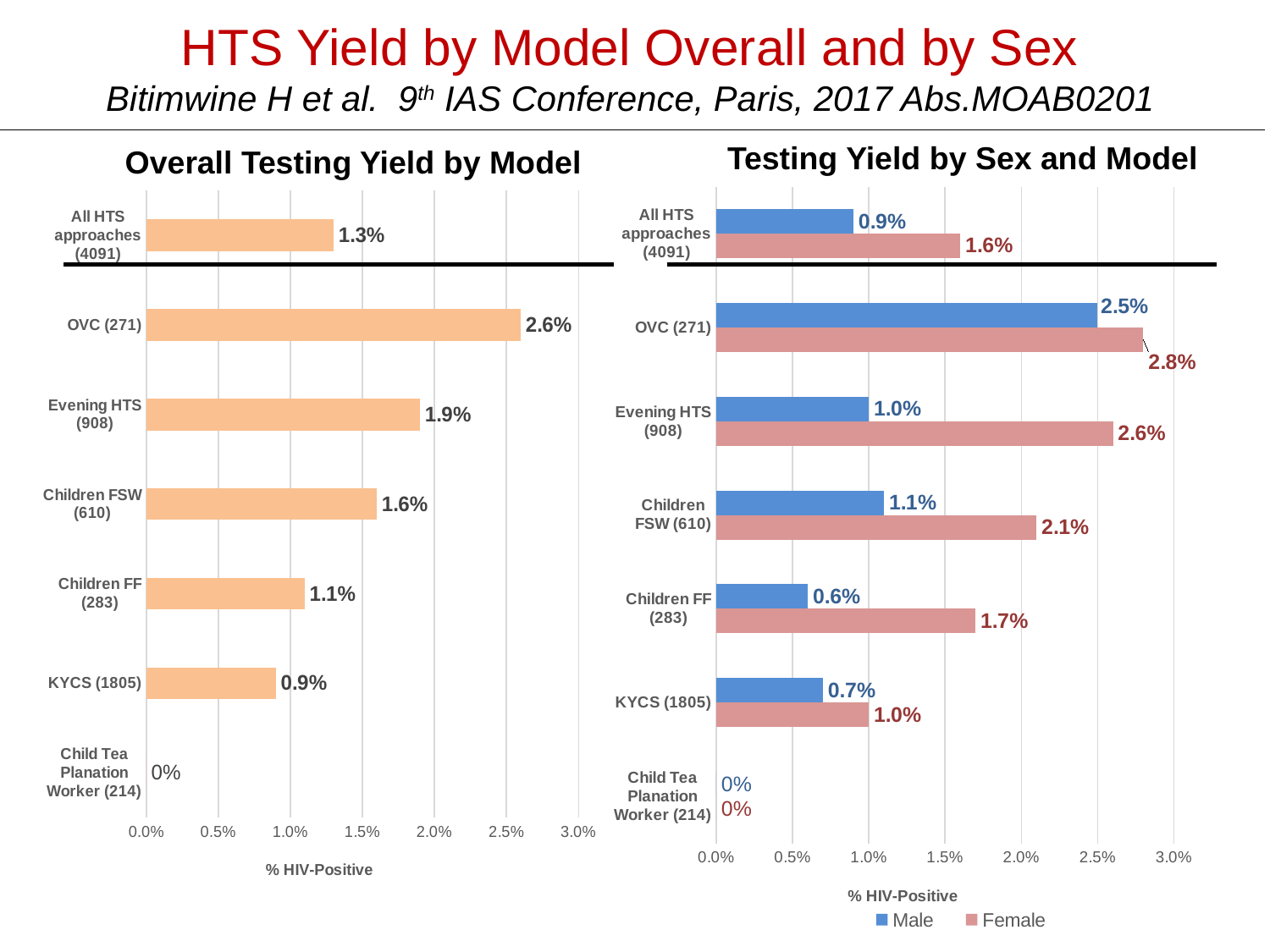
What type of chart is the 'Overall Testing Yield by Model' chart? Bar chart In the 'Testing Yield by Sex and Model' chart, what is the difference between the Female and Male values for All HTS approaches (4091)? 0.7% How many series does the legend of the 'Testing Yield by Sex and Model' chart list? 2 In the 'Overall Testing Yield by Model' chart, which model has the highest yield? OVC (271) In the 'Overall Testing Yield by Model' chart, how many categories are shown? 7 In the 'Testing Yield by Sex and Model' chart, what is the Female value for Evening HTS (908)? 2.6% In the 'Testing Yield by Sex and Model' chart, what is the Male value for Children FF (283)? 0.6% In the 'Testing Yield by Sex and Model' chart, which is larger for Children FSW (610), the Male or the Female value? Female In the 'Overall Testing Yield by Model' chart, what is the value for OVC (271)? 2.6% In the 'Overall Testing Yield by Model' chart, what is the value for KYCS (1805)? 0.9% In the 'Testing Yield by Sex and Model' chart, which model has the highest Female yield? OVC (271) In the 'Overall Testing Yield by Model' chart, what is the difference between Evening HTS (908) and Children FF (283)? 0.8%